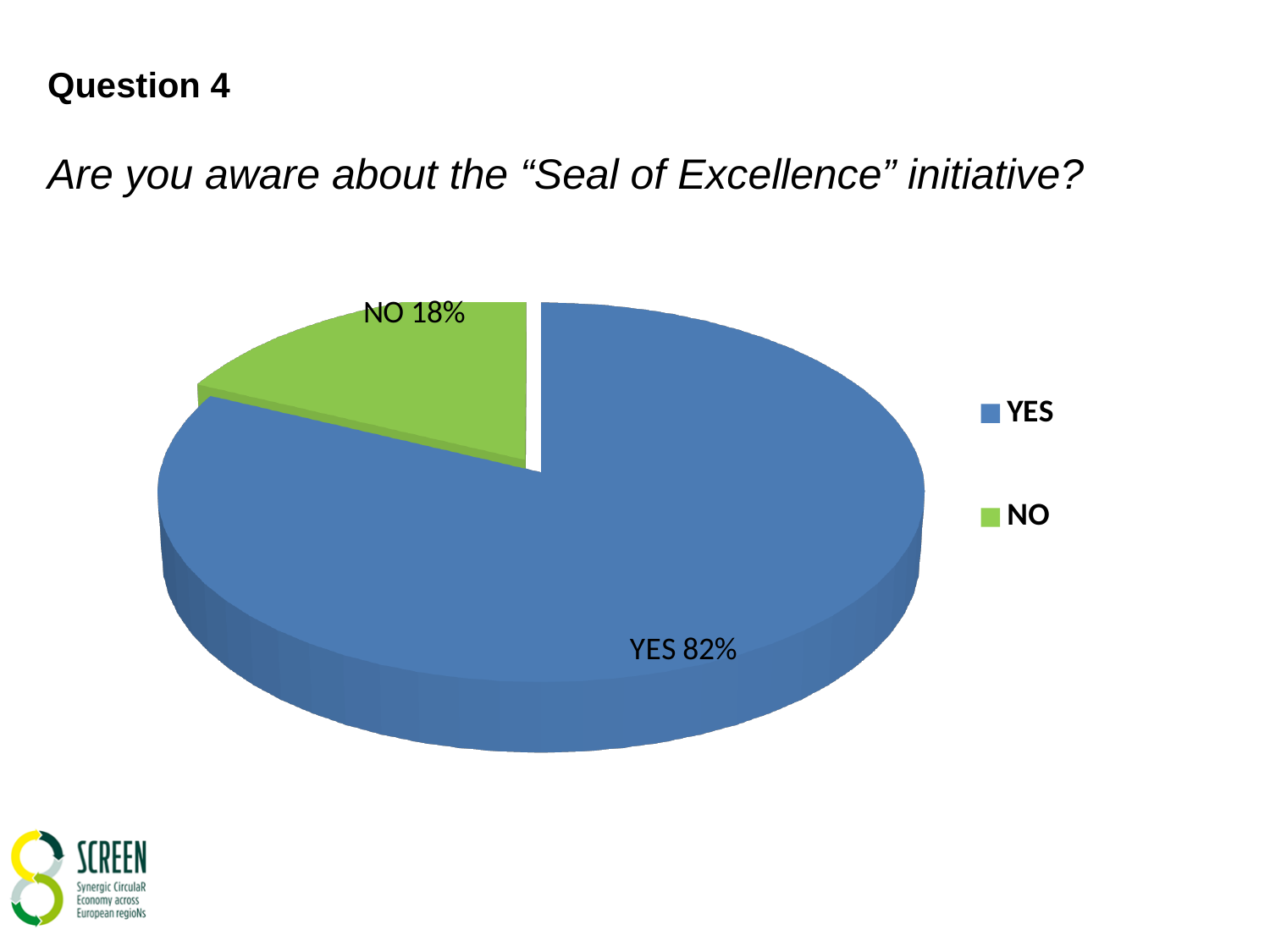
What percentage of respondents answered YES? 82% What kind of chart is shown on the slide? pie chart What percentage of respondents answered NO? 18% What colour is the YES slice? blue What is the difference in percentage points between the YES and NO slices? 64 How many entries does the legend list? 2 What colour is the NO slice? green Which slice is the smallest? NO Which is larger, the YES slice or the NO slice? YES What share of the pie does the NO slice represent? 18% Which slice is the largest? YES How many slices does the pie chart have? 2